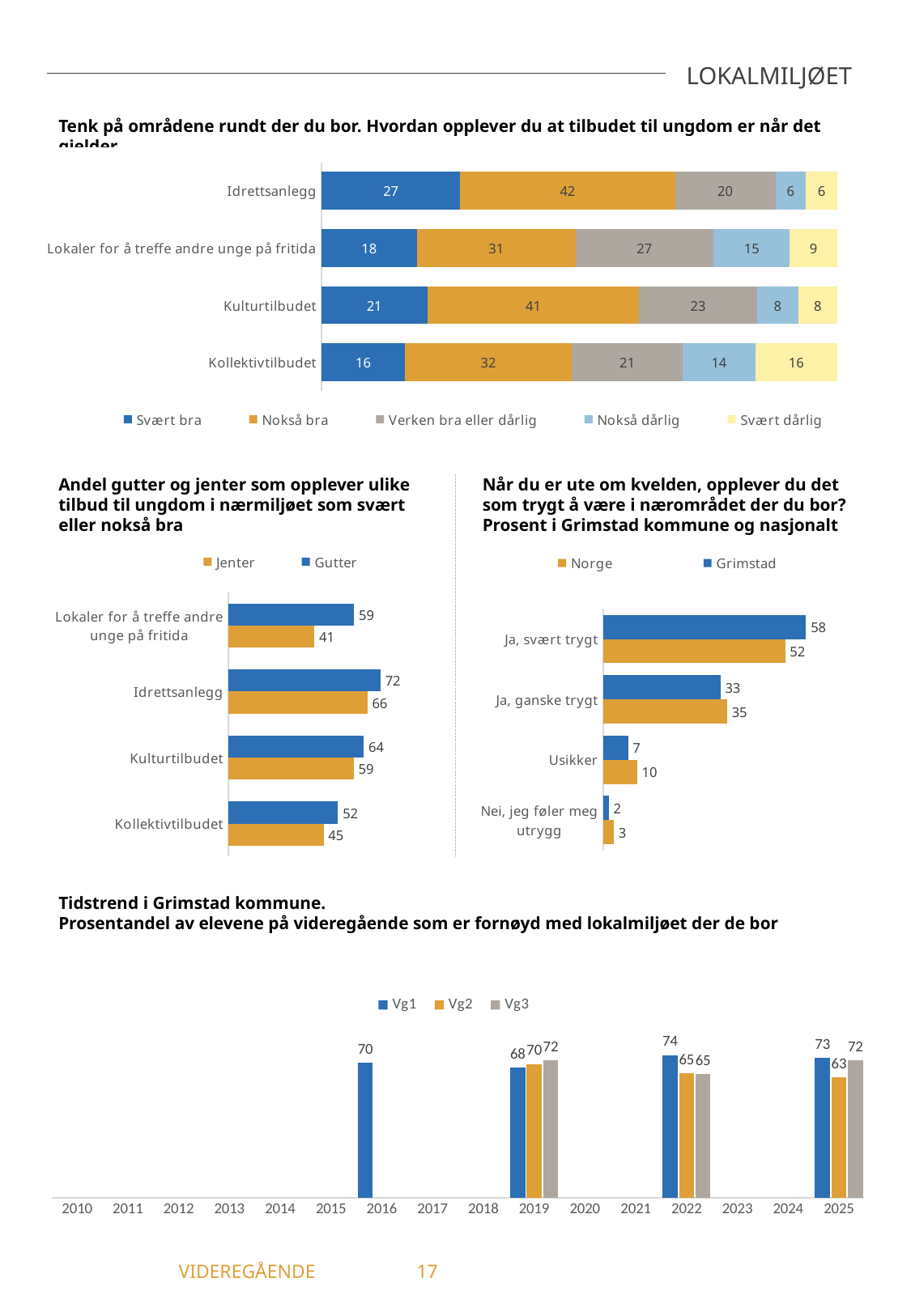
In the chart 'Andel gutter og jenter som opplever ulike tilbud til ungdom i nærmiljøet som svært eller nokså bra', what is the Jenter value for Idrettsanlegg? 66 In the chart 'Tidstrend i Grimstad kommune', which year has the highest Vg1 value? 2022 In the top chart 'Tenk på områdene rundt der du bor', what is the 'Svært dårlig' value for Kollektivtilbudet? 16 In the chart 'Andel gutter og jenter som opplever ulike tilbud til ungdom i nærmiljøet som svært eller nokså bra', which category has the lowest Jenter value? Lokaler for å treffe andre unge på fritida What kind of chart is the 'Tidstrend i Grimstad kommune' chart at the bottom of the slide? Bar chart In the chart 'Andel gutter og jenter som opplever ulike tilbud til ungdom i nærmiljøet som svært eller nokså bra', what is the difference between Gutter and Jenter for 'Lokaler for å treffe andre unge på fritida'? 18 In the top chart 'Tenk på områdene rundt der du bor', what is the 'Svært bra' value for Idrettsanlegg? 27 In the chart 'Når du er ute om kvelden, opplever du det som trygt å være i nærområdet der du bor?', what is the Grimstad value for 'Ja, svært trygt'? 58 In the chart 'Når du er ute om kvelden, opplever du det som trygt å være i nærområdet der du bor?', which is larger for 'Usikker': Norge or Grimstad? Norge In the top chart 'Tenk på områdene rundt der du bor', how many series does the legend list? 5 In the top chart 'Tenk på områdene rundt der du bor', what is the total of the stacked bar for Kulturtilbudet? 101 In the chart 'Tidstrend i Grimstad kommune', what is the Vg2 value for 2025? 63